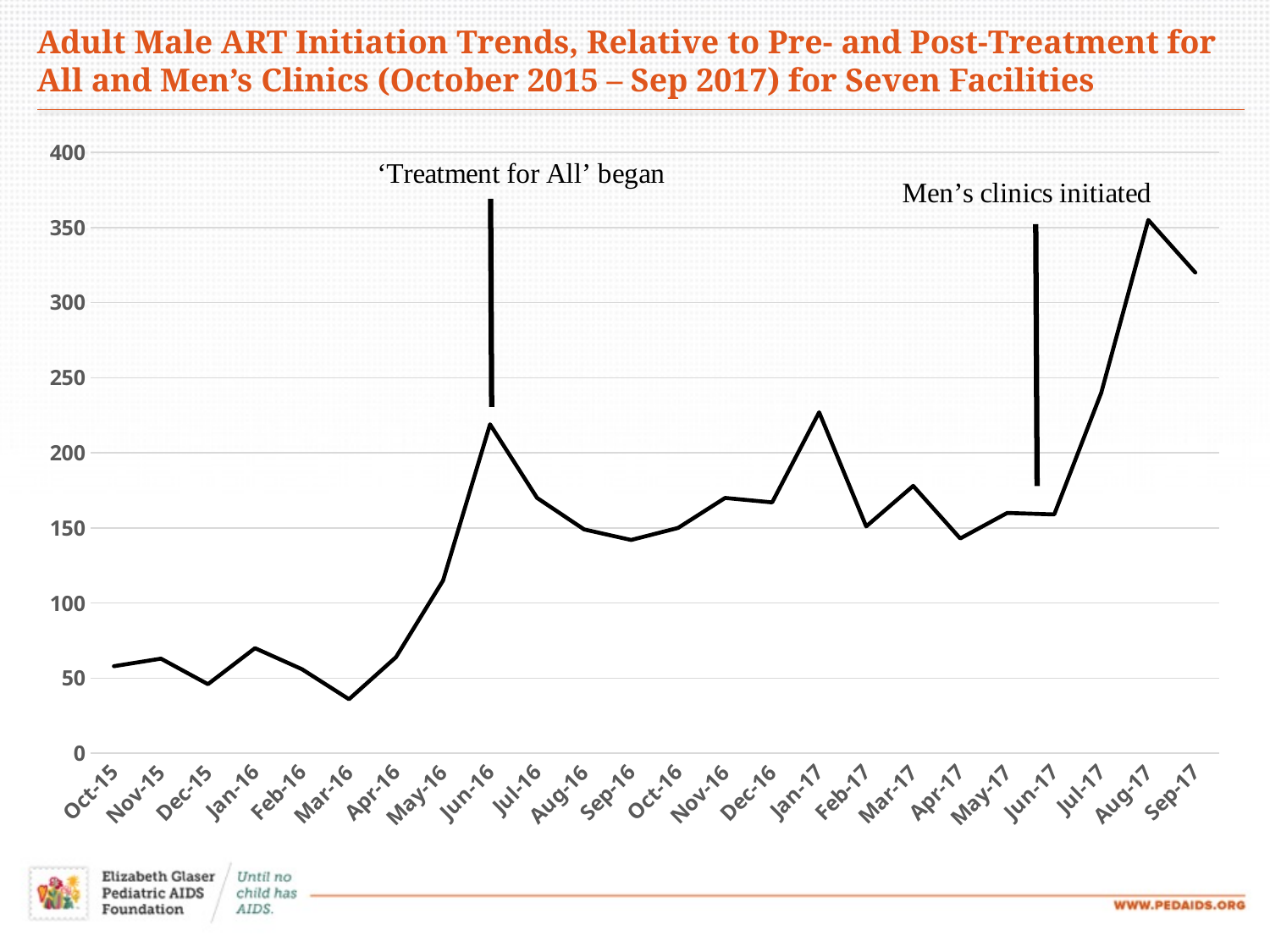
Do the values rise or fall from Jun-17 to Aug-17? Rise Which month has the highest value? Aug-17 Is the value for Mar-16 greater or less than 50? less Is the value for Sep-17 greater or less than 300? greater Is the value for Jun-16 greater or less than 200? greater Which event is annotated on the chart near Jun-17? Men's clinics initiated How many months are plotted along the x axis? 24 Which month has the lowest value? Mar-16 Which event is annotated on the chart near Jun-16? 'Treatment for All' began What kind of chart is shown on the slide? Line chart Which is larger, the value for Jan-17 or the value for Mar-17? Jan-17